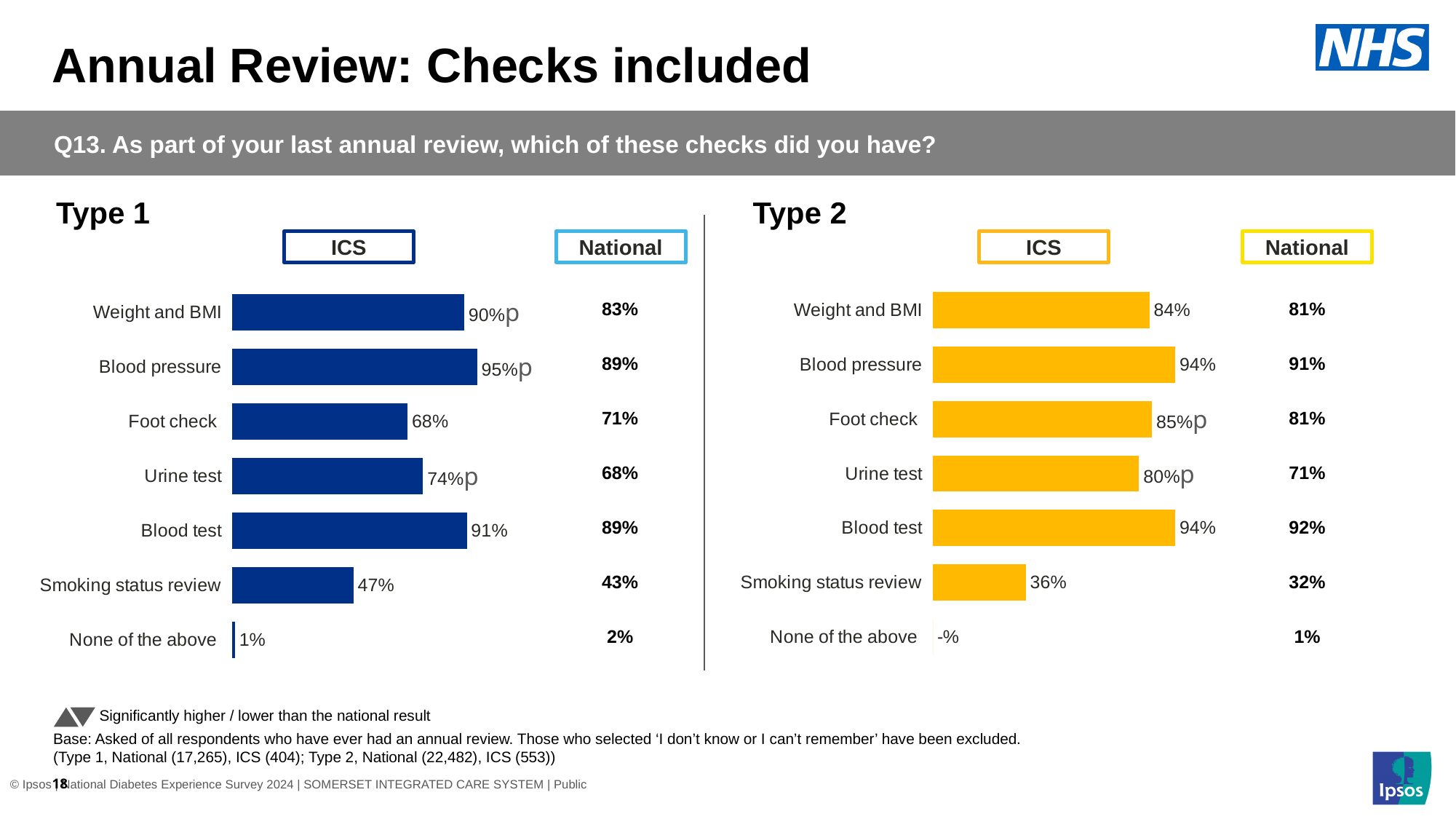
In the Type 1 chart, which check has the highest ICS value? Blood pressure In the Type 1 chart, what is the difference between the ICS and National values for Weight and BMI? 7 percentage points What colour are the ICS bars in the Type 2 chart? yellow How many checks are listed in the Type 2 chart? 7 In the Type 1 chart, what is the ICS value for Blood pressure? 95% In the Type 1 chart, what is the National value for Foot check? 71% In the Type 2 chart, which check has the lowest ICS value? None of the above In the Type 2 chart, what is the National value for Urine test? 71% What type of chart is used for the Type 1 ICS results? bar chart In the Type 2 chart, what is the ICS value for Smoking status review? 36% In the Type 1 chart, is the ICS value for Urine test higher or lower than the ICS value for Foot check? higher In the Type 2 chart, what is the difference between the ICS and National values for Foot check? 4 percentage points